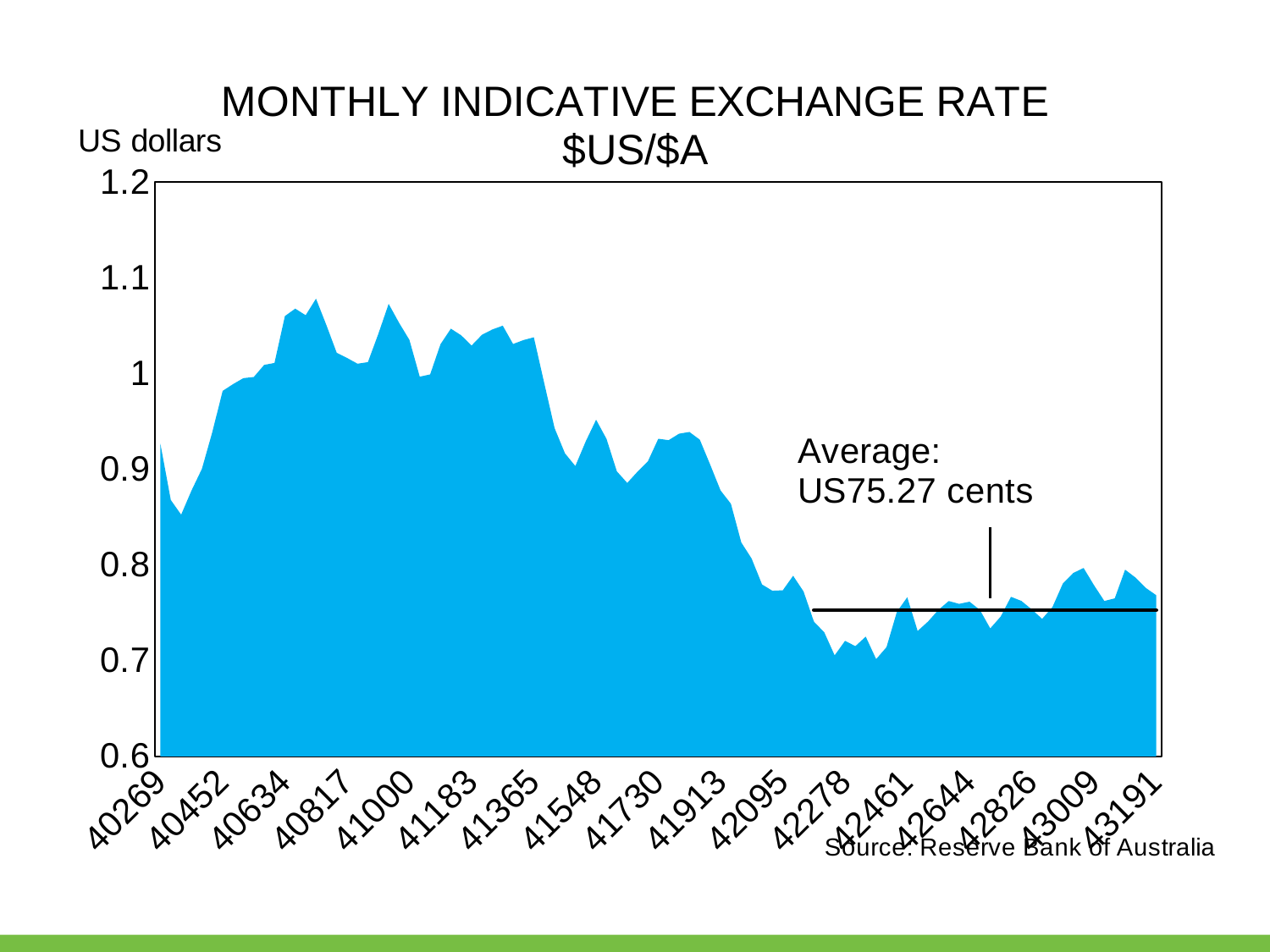
Is the exchange rate at 42278 greater or less than 0.8? less What is the highest value shown on the vertical axis? 1.2 What average value is annotated on the chart? US75.27 cents What kind of chart is shown on the slide? Area chart What is the title of the chart? MONTHLY INDICATIVE EXCHANGE RATE $US/$A Is the exchange rate at 41183 greater or less than 0.9? greater How many tick labels are shown on the horizontal axis? 17 Overall, does the exchange rate rise or fall from the left of the chart to the right? fall Is the exchange rate at 40817 greater or less than 1? greater What unit is labelled on the vertical axis of the chart? US dollars